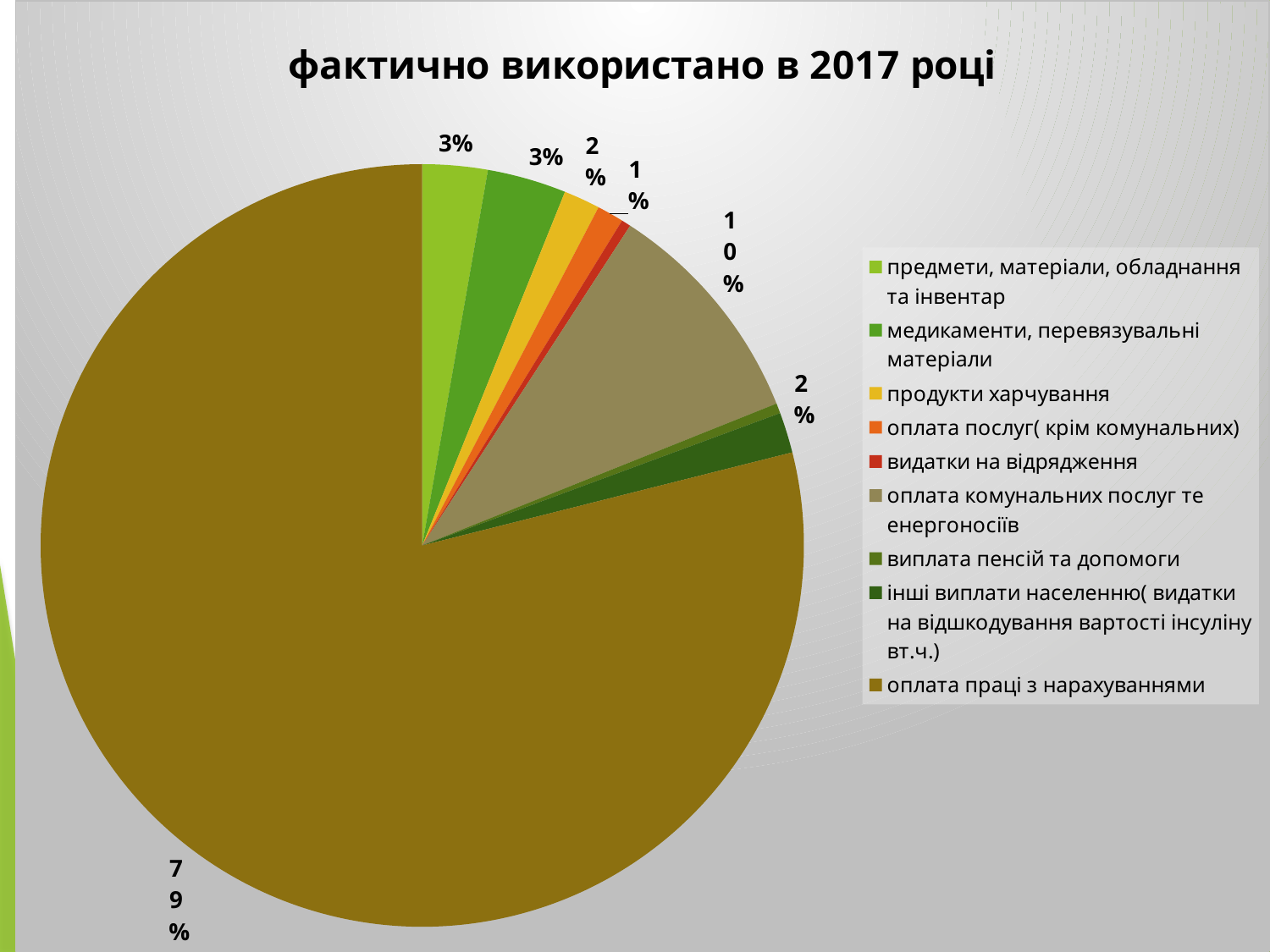
What is the difference in percentage points between оплата праці з нарахуваннями (79%) and оплата комунальних послуг те енергоносіїв (10%)? 69 What share of the pie is оплата праці з нарахуваннями? 79% What kind of chart is shown on the slide? pie chart What share of the pie is оплата комунальних послуг те енергоносіїв? 10% What is the value shown for медикаменти, перевязувальні матеріали? 3% Which category has the largest share of the pie? оплата праці з нарахуваннями What is the value shown for предмети, матеріали, обладнання та інвентар? 3% What is the value shown for продукти харчування? 2% Which is larger: оплата праці з нарахуваннями or оплата комунальних послуг те енергоносіїв? оплата праці з нарахуваннями How many categories does the legend list? 9 What colour is the slice for оплата праці з нарахуваннями? brown What is the title of the chart? фактично використано в 2017 році